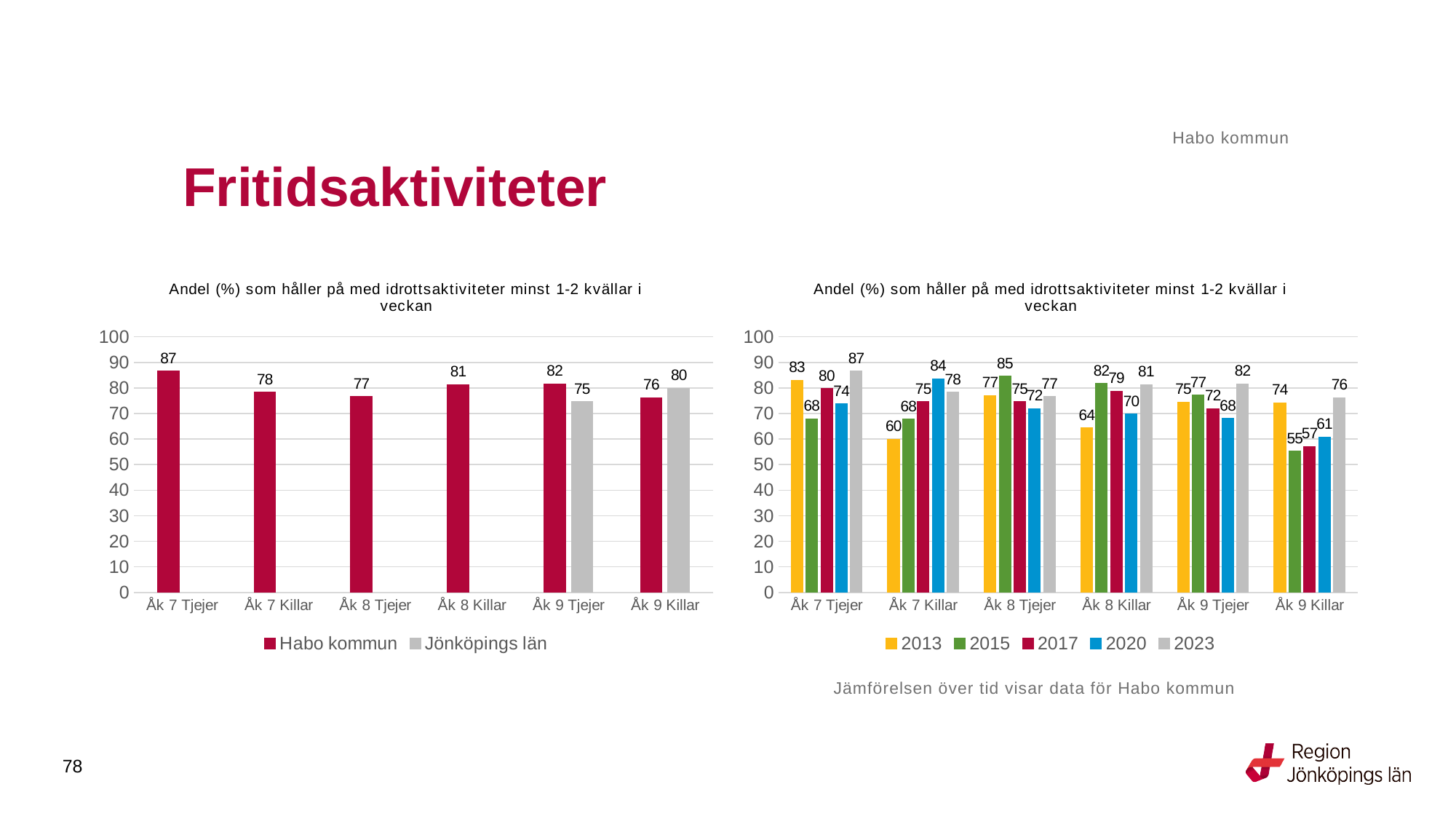
In the right chart, which year has the highest value for Åk 8 Tjejer? 2015 In the left chart, how many series does the legend list? 2 In the right chart, what is the value for 2015 for Åk 9 Killar? 55 In the left chart, which category has the lowest Habo kommun value? Åk 9 Killar In the right chart, what is the value for 2020 for Åk 7 Killar? 84 In the left chart, what is the value for Habo kommun for Åk 7 Tjejer? 87 In the left chart, what is the difference between Habo kommun and Jönköpings län for Åk 9 Tjejer? 7 In the right chart, is the 2013 value for Åk 8 Killar larger or smaller than the 2023 value for Åk 8 Killar? smaller What kind of chart is the right chart? Bar chart In the right chart, how many series does the legend list? 5 In the left chart, what is the value for Jönköpings län for Åk 9 Killar? 80 In the right chart, what is the difference between the 2023 and 2013 values for Åk 9 Tjejer? 7